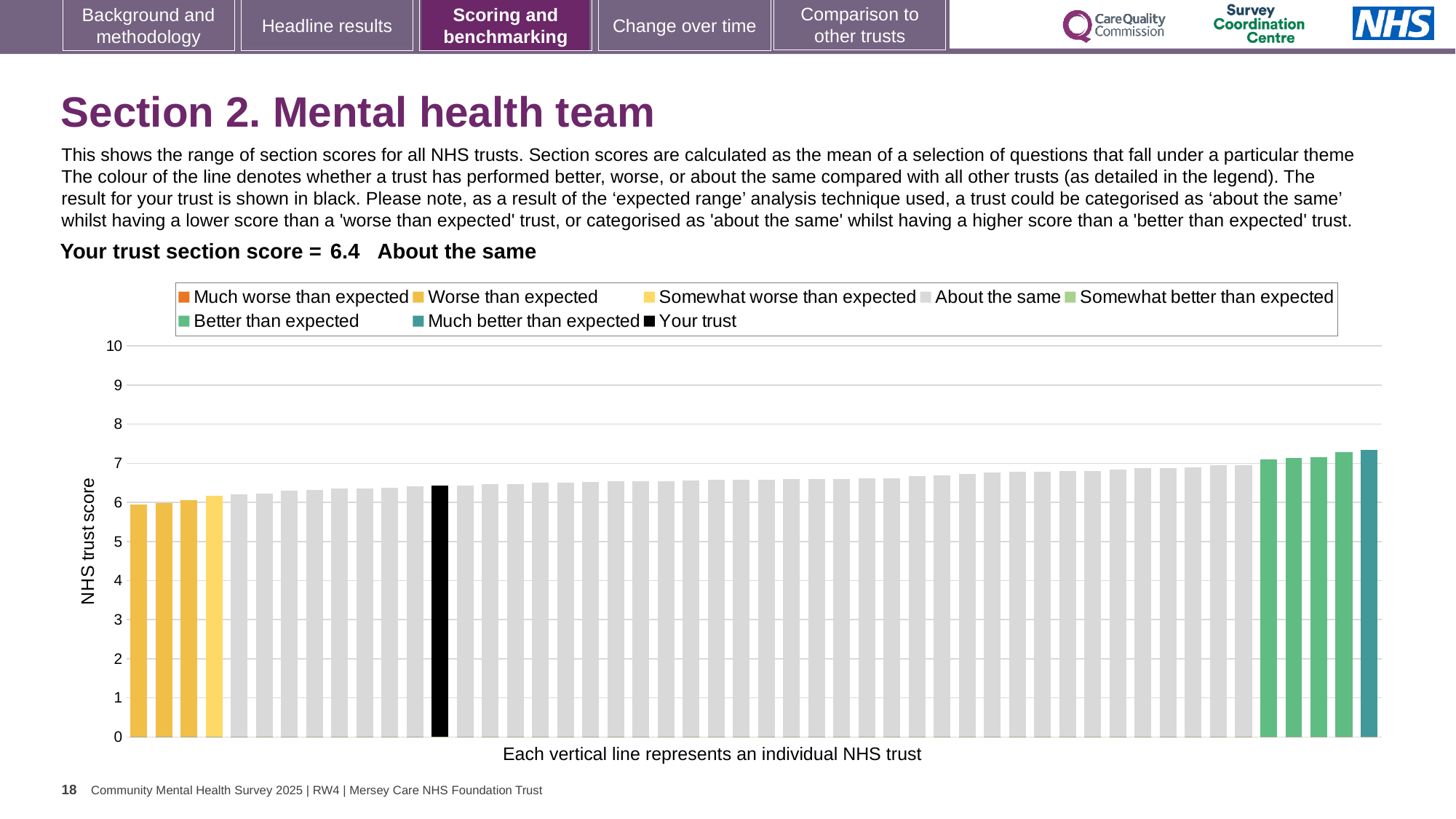
What is the section score for your trust shown on the slide? 6.4 How many entries does the chart legend list? 8 Is the value for your trust (the black bar) greater or less than 6? greater What kind of chart is shown on the slide? bar chart Is the value of the tallest bar (rightmost trust) greater or less than 7? greater Is the value of the tallest bar greater or less than 8? less Do the bar values rise or fall from left to right along the x axis? rise How many bars are coloured in the 'Much better than expected' (teal) colour? 1 What colour is the bar representing your trust? black Which bar is the highest: the leftmost bar or the rightmost bar? the rightmost bar What is the label on the y axis of the chart? NHS trust score Which category is your trust placed in for this section? About the same